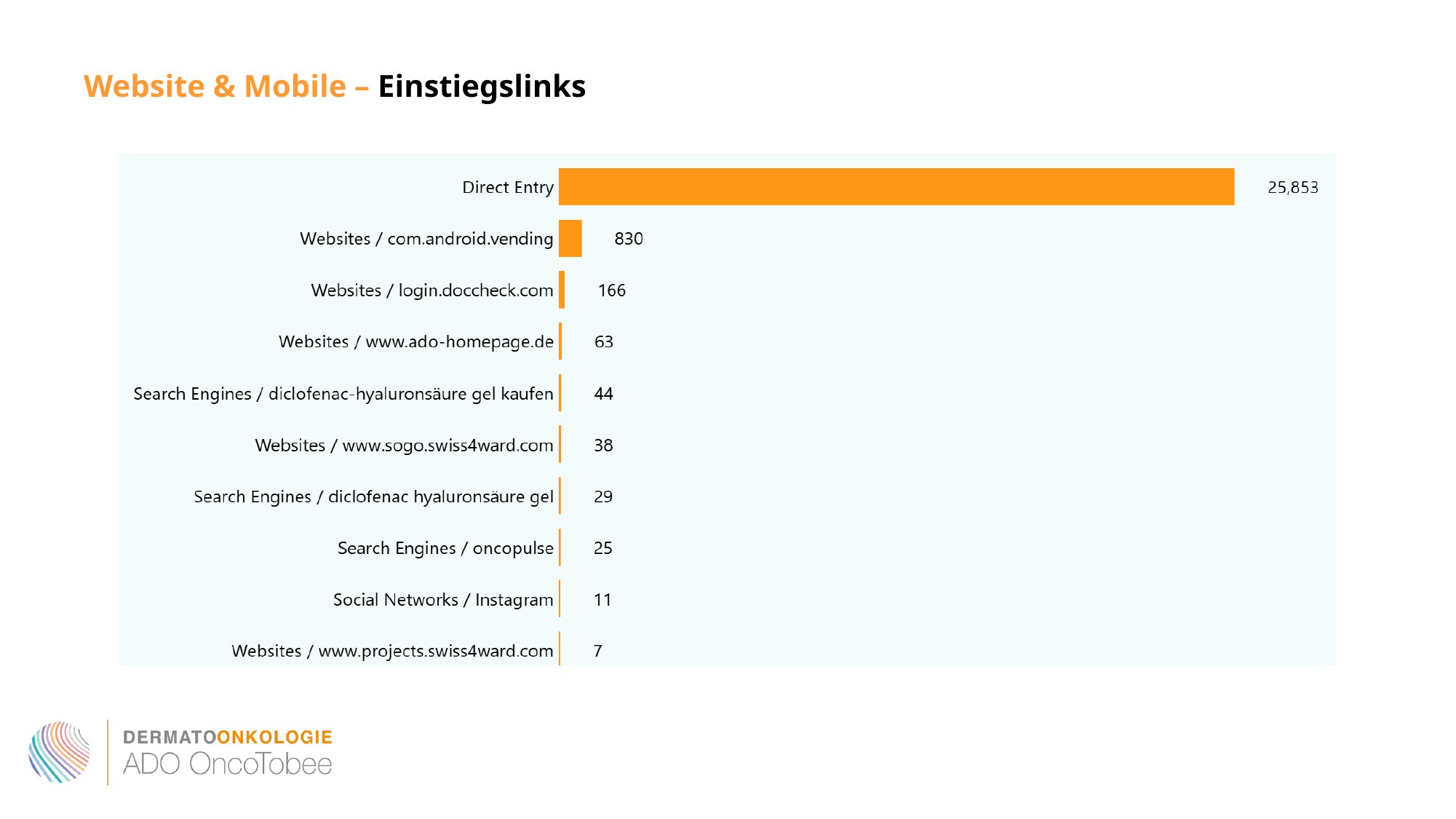
What kind of chart is shown on the slide? Bar chart Which category has the lowest value? Websites / www.projects.swiss4ward.com What is the value for Social Networks / Instagram? 11 Which category has the highest value? Direct Entry What is the value for Websites / com.android.vending? 830 What colour are the bars in the chart? Orange Which is larger, Search Engines / oncopulse or Search Engines / diclofenac hyaluronsäure gel? Search Engines / diclofenac hyaluronsäure gel What is the difference between Search Engines / diclofenac-hyaluronsäure gel kaufen and Websites / www.sogo.swiss4ward.com? 6 What is the value for Websites / login.doccheck.com? 166 What is the difference between Websites / com.android.vending and Websites / login.doccheck.com? 664 How many categories are shown in the chart? 10 What is the value for Direct Entry? 25,853